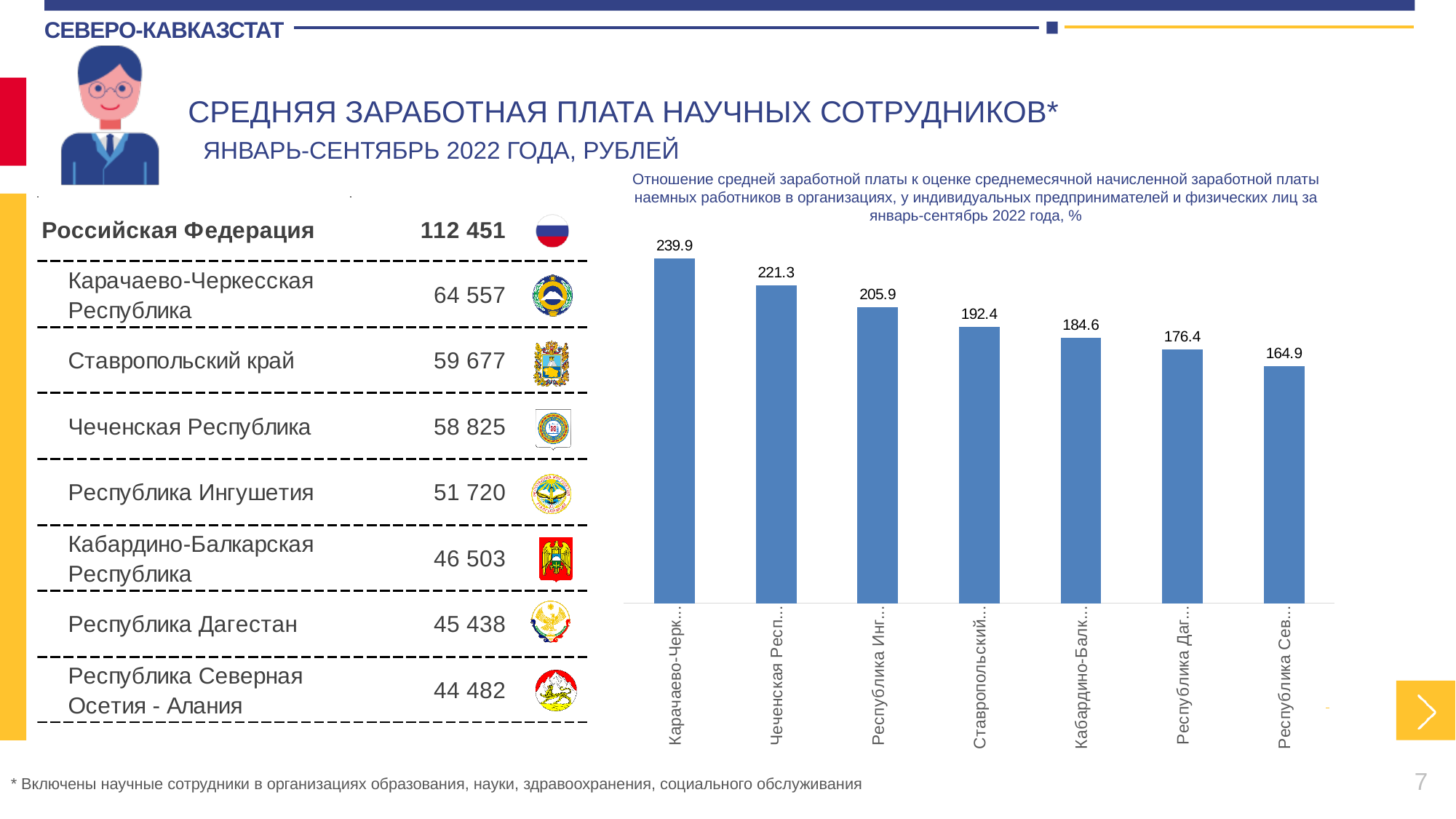
What type of chart is shown on the right side of the slide? bar chart In the chart on the right, which region has the lowest value? Республика Северная Осетия - Алания What unit is stated in the title of the chart on the right? % In the chart on the right, what is the value for Карачаево-Черкесская Республика? 239.9 In the chart on the right, what is the difference between the values for Карачаево-Черкесская Республика and Республика Северная Осетия - Алания? 75.0 In the chart on the right, what is the value for Республика Дагестан? 176.4 In the chart on the right, do the values rise or fall from left to right along the x axis? fall How many bars (regions) are plotted in the chart on the right? 7 In the chart on the right, what is the value for Ставропольский край? 192.4 In the chart on the right, which region has the highest value? Карачаево-Черкесская Республика In the chart on the right, which is larger: the value for Республика Ингушетия or for Кабардино-Балкарская Республика? Республика Ингушетия In the chart on the right, what is the value for Чеченская Республика? 221.3